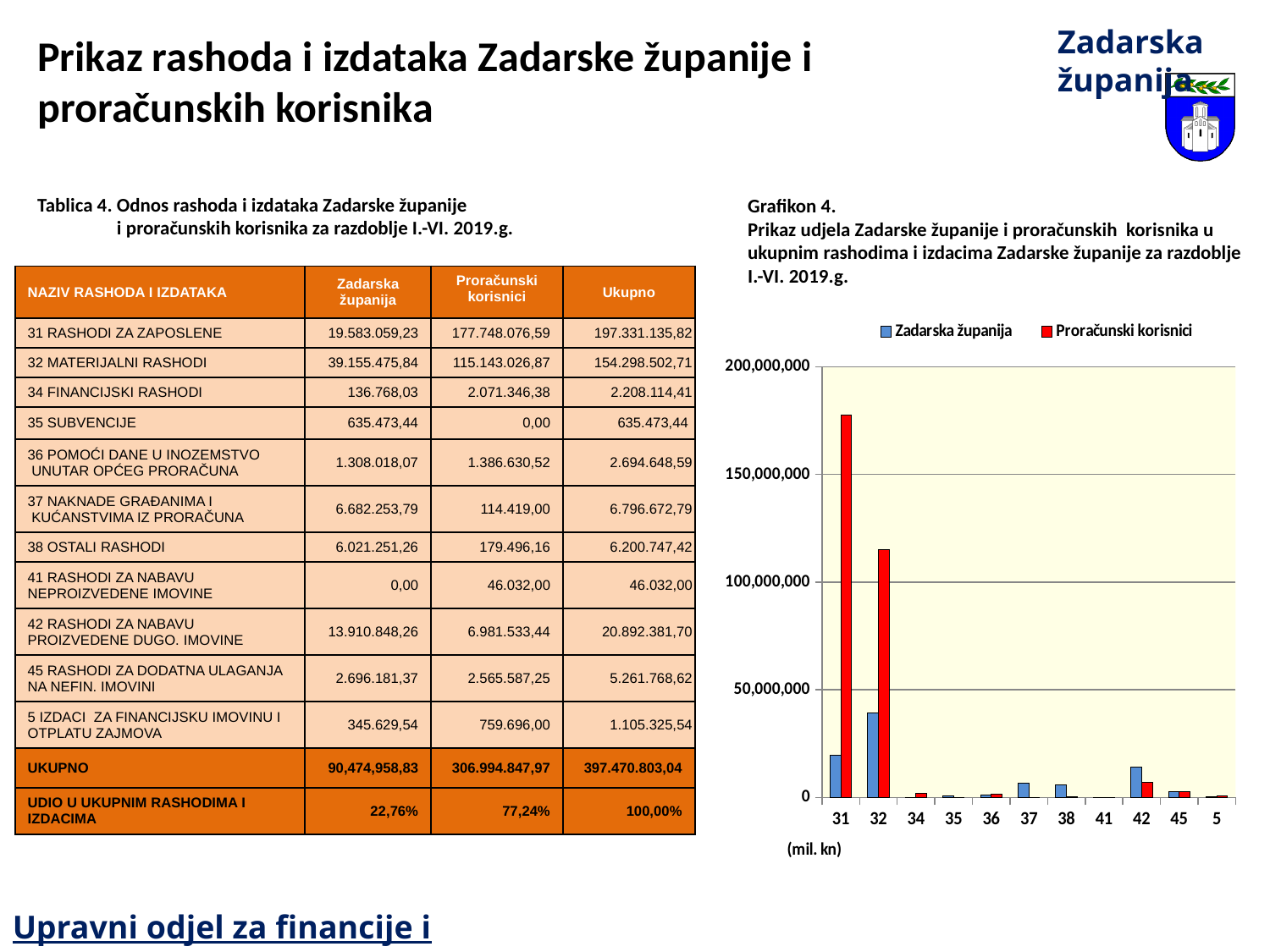
In Grafikon 4, which category has the highest value for Proračunski korisnici? 31 What kind of chart is Grafikon 4? bar chart In Grafikon 4, is the Zadarska županija value for category 32 greater or less than 50,000,000? less How many series does the legend of Grafikon 4 list? 2 What unit label is shown below the x axis of Grafikon 4? (mil. kn) In Grafikon 4, which category has the highest value for Zadarska županija? 32 In Grafikon 4, for category 31, which series has the larger value: Zadarska županija or Proračunski korisnici? Proračunski korisnici In Grafikon 4, is the Proračunski korisnici value for category 31 greater or less than 150,000,000? greater In Grafikon 4, which colour represents the Proračunski korisnici series? red In Grafikon 4, is the Proračunski korisnici value for category 32 greater or less than 100,000,000? greater How many categories are shown on the x axis of Grafikon 4? 11 In Grafikon 4, for category 42, which series has the larger value: Zadarska županija or Proračunski korisnici? Zadarska županija